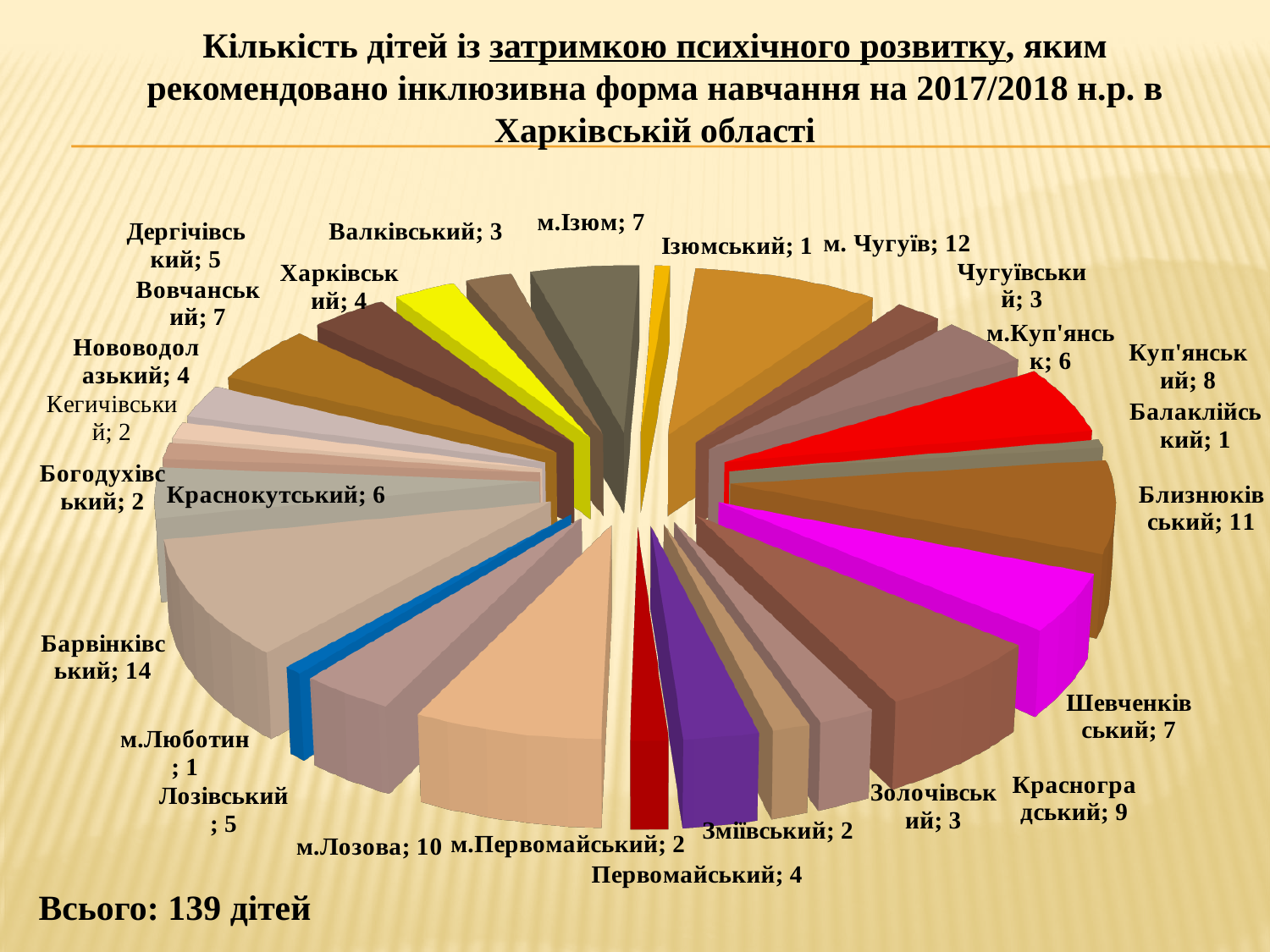
What is the total number of children shown on the slide? 139 What is the value for Близнюківський? 11 What type of chart is shown on the slide? pie chart What is the difference between the values for Барвінківський and м. Чугуїв? 2 What is the value for м. Чугуїв? 12 How many children are shown for Барвінківський? 14 Which category has the largest slice of the pie? Барвінківський What is the value for Красноградський? 9 Which is larger, the value for Куп'янський or the value for м.Куп'янськ? Куп'янський For which school year does the chart show the data? 2017/2018 How many categories (slices) does the pie chart have? 26 What is the value for м.Лозова? 10